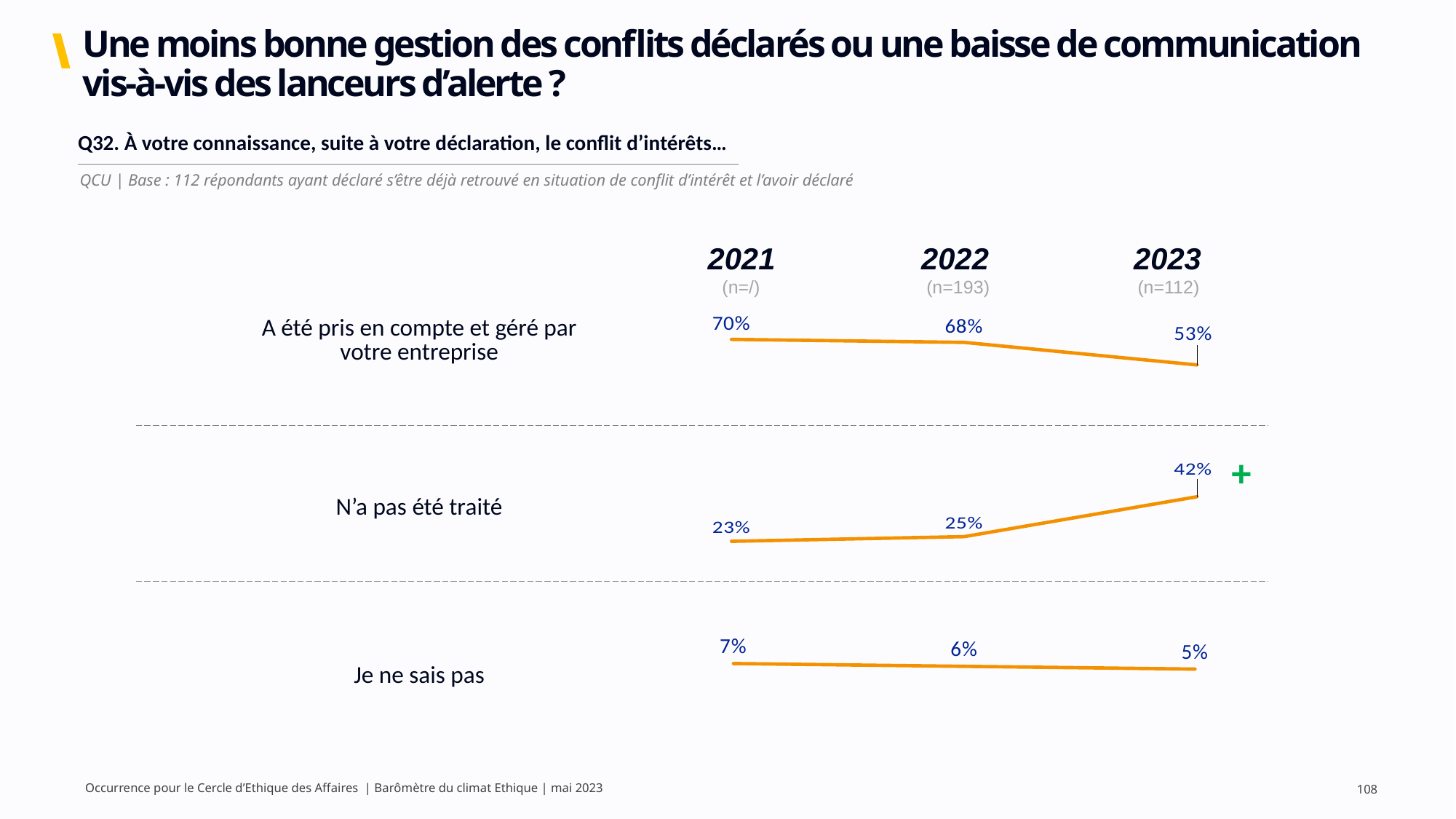
In the chart for "N'a pas été traité", what is the difference between the 2023 and 2022 values? 17 percentage points In the chart for "A été pris en compte et géré par votre entreprise", which year has the highest value? 2021 In the chart for "Je ne sais pas", which is larger, the value for 2021 or the value for 2023? 2021 In the chart for "N'a pas été traité", do the values rise or fall from 2021 to 2023? rise In the chart for "A été pris en compte et géré par votre entreprise", what is the difference between the 2021 and 2023 values? 17 percentage points In the chart for "A été pris en compte et géré par votre entreprise", what is the value for 2023? 53% What kind of chart is used for each row on the slide? line chart In the chart for "N'a pas été traité", what is the value for 2021? 23% In the chart for "A été pris en compte et géré par votre entreprise", do the values rise or fall from 2021 to 2023? fall How many data points does the chart for "Je ne sais pas" show? 3 In the chart for "N'a pas été traité", which year has the lowest value? 2021 In the chart for "Je ne sais pas", what is the value for 2022? 6%